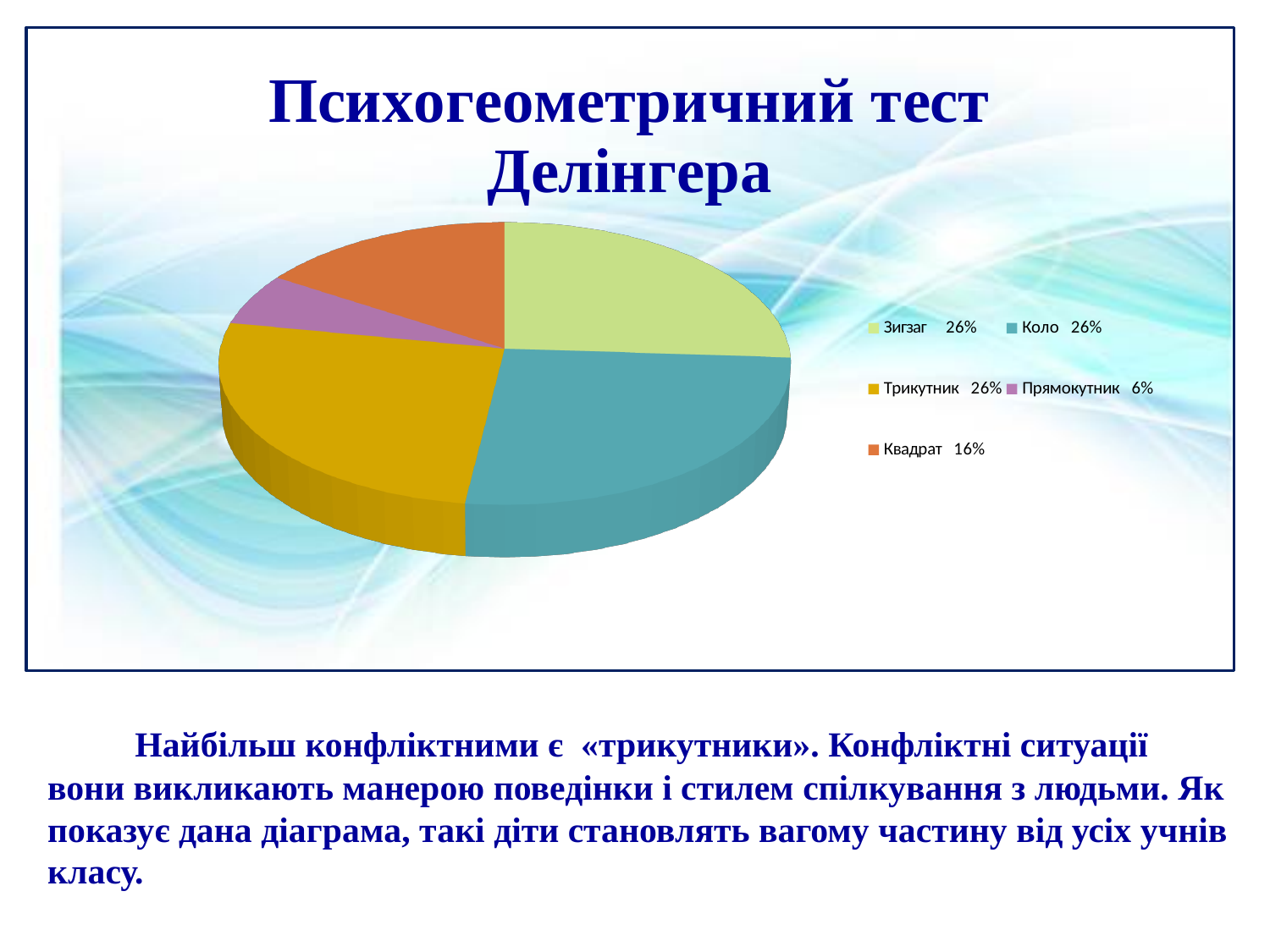
Which category has the smallest slice of the pie? Прямокутник What is the title of the chart? Психогеометричний тест Делінгера What share of the pie does Квадрат have? 16% What is the difference between the shares for Коло and Квадрат? 10% Which category is shown in purple in the legend? Прямокутник What kind of chart is shown on the slide? pie chart What share of the pie does Прямокутник have? 6% How many slices does the pie chart have? 5 What is the difference between the shares for Квадрат and Прямокутник? 10% What share of the pie does Зигзаг have? 26% Which is larger, the share for Квадрат or the share for Прямокутник? Квадрат